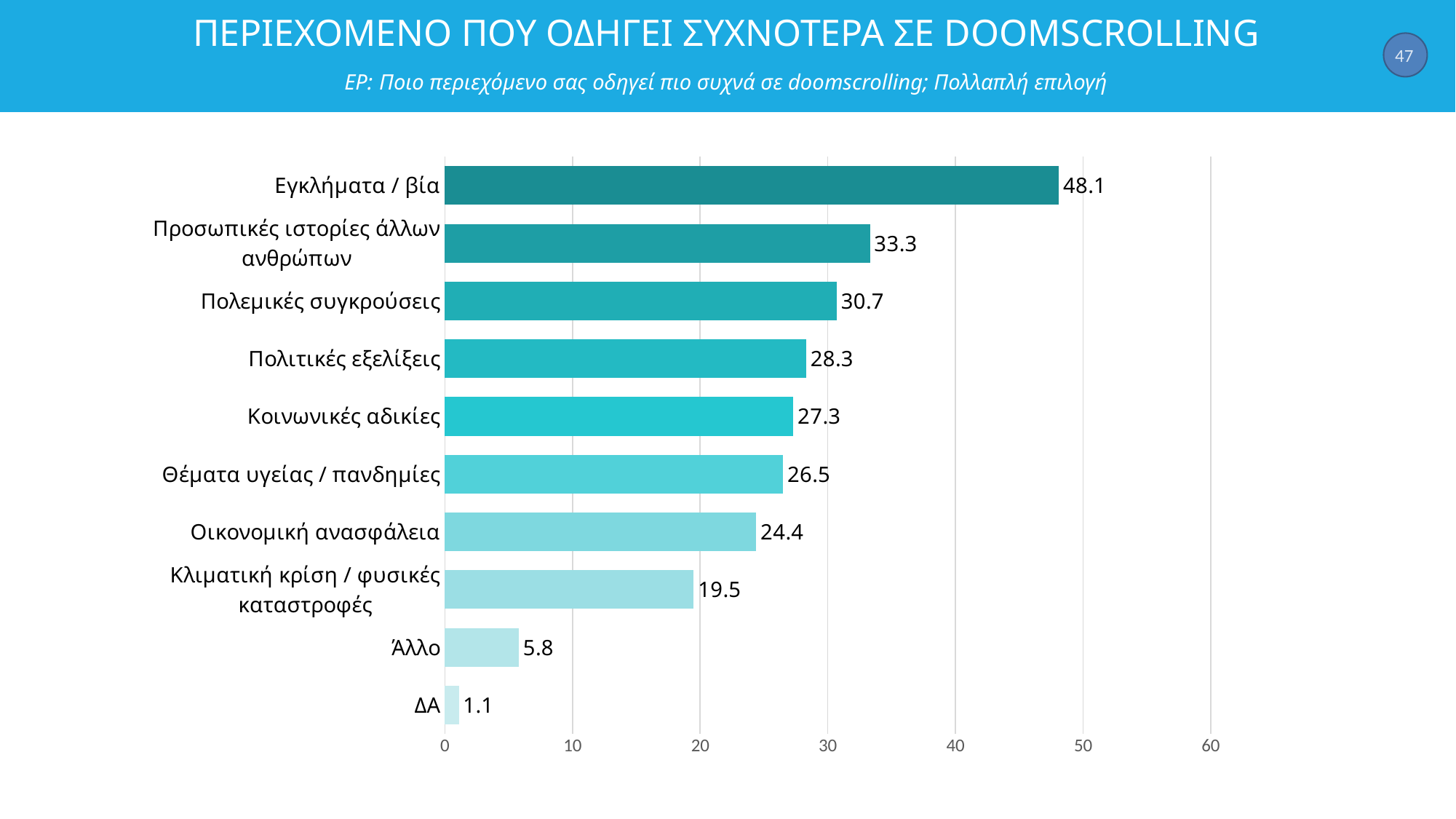
What kind of chart is shown on the slide? bar chart Which category has the lowest value? ΔΑ What is the value for Εγκλήματα / βία? 48.1 What is the value for Πολεμικές συγκρούσεις? 30.7 What is the difference between the values for Εγκλήματα / βία and Προσωπικές ιστορίες άλλων ανθρώπων? 14.8 What is the highest tick value shown on the horizontal axis? 60 How many categories are shown in the chart? 10 Is the value for Θέματα υγείας / πανδημίες greater or less than 30? less What is the value for Άλλο? 5.8 What is the value for Κλιματική κρίση / φυσικές καταστροφές? 19.5 Which category has the highest value? Εγκλήματα / βία Which is larger, the value for Πολιτικές εξελίξεις or the value for Οικονομική ανασφάλεια? Πολιτικές εξελίξεις